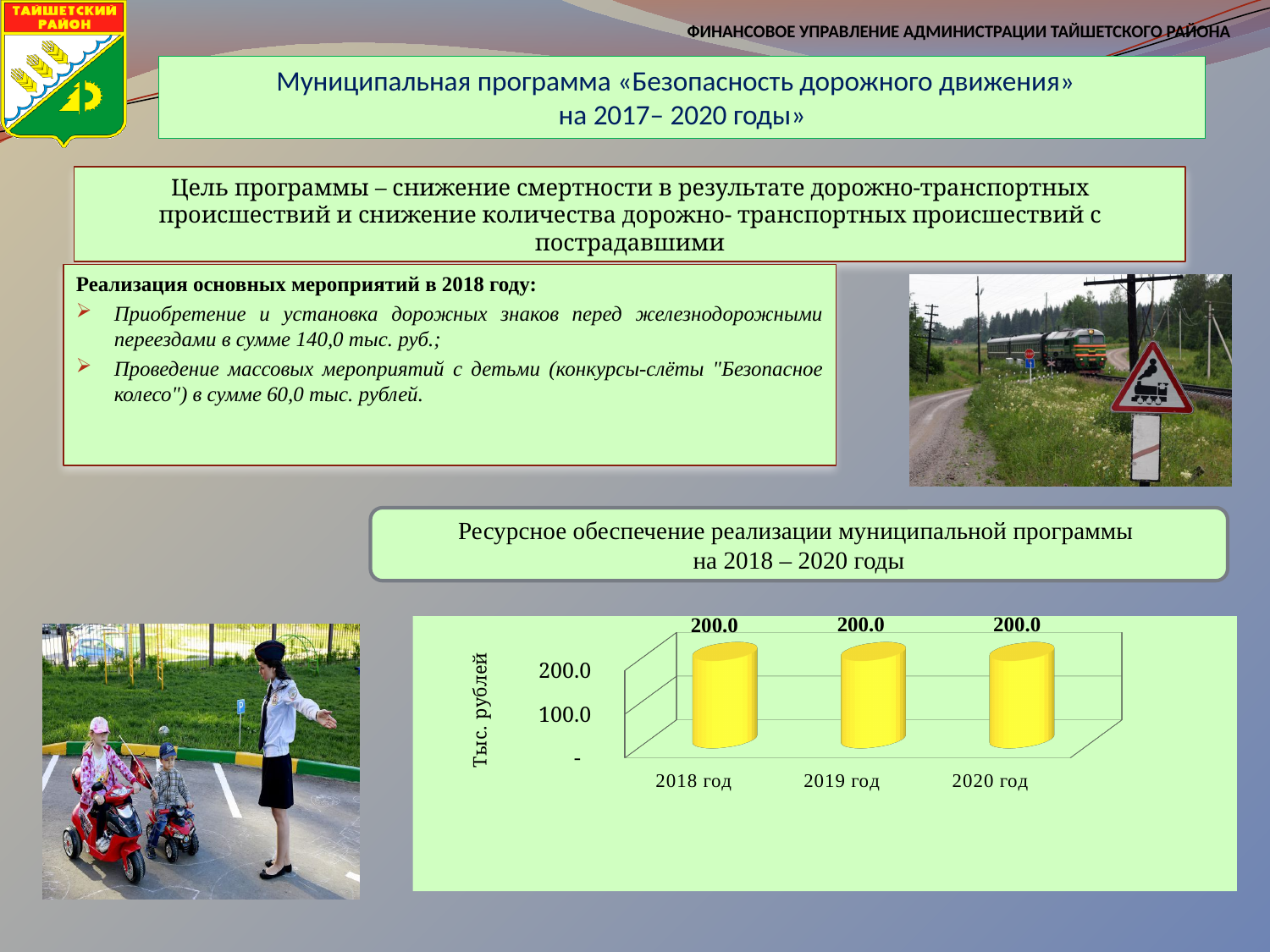
What kind of chart is shown on the slide? bar chart What is the difference between the values for 2018 год and 2020 год? 0.0 What is the value for 2020 год? 200.0 What is the value for 2019 год? 200.0 How many categories are shown on the x axis of the chart? 3 Is the value for 2019 год greater or less than 100.0? greater What colour are the bars in the chart? yellow What is the label of the vertical axis of the chart? Тыс. рублей What is the value for 2018 год? 200.0 Do the values rise, fall or stay the same from 2018 год to 2020 год? stay the same